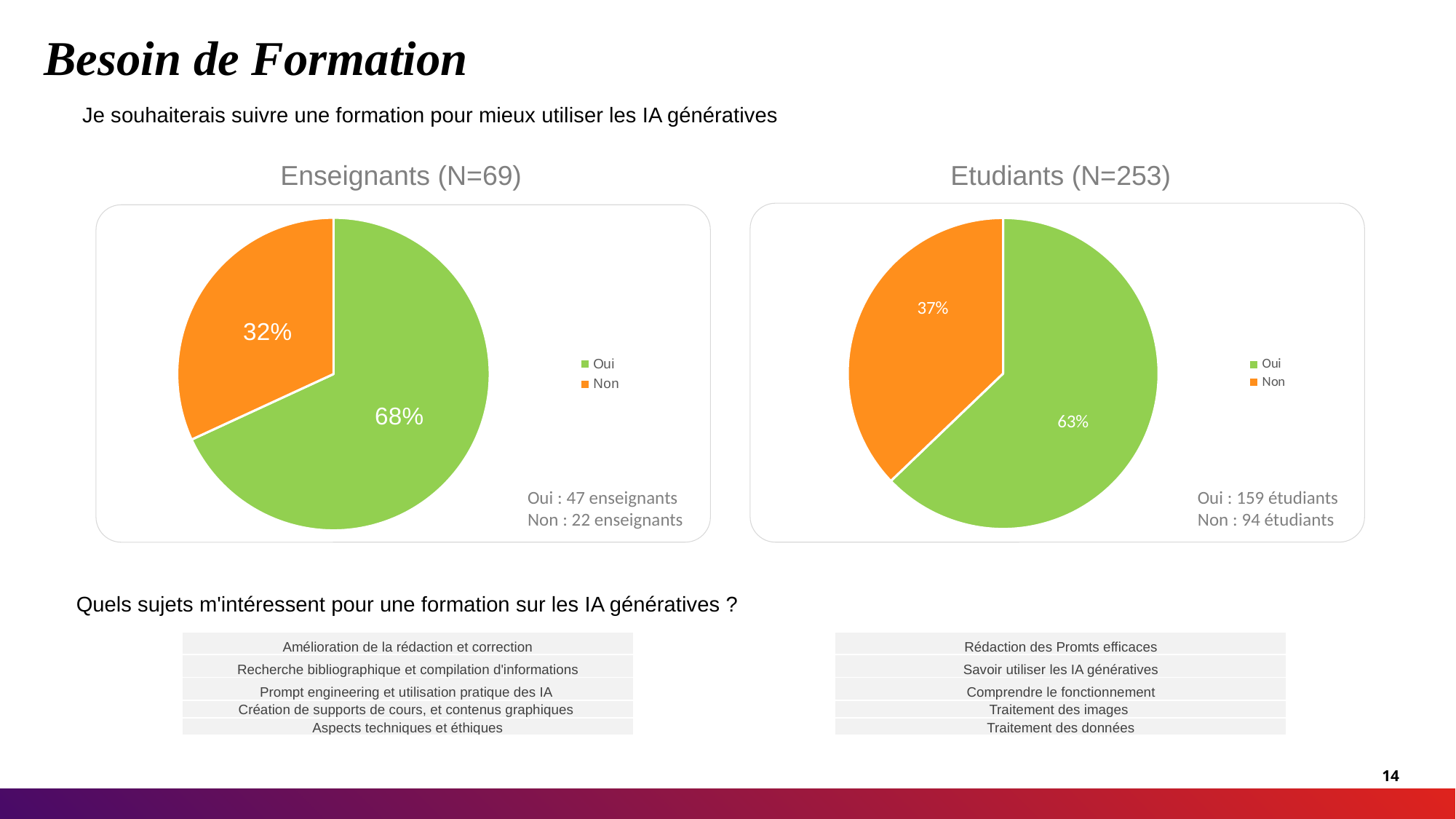
In the Etudiants (N=253) chart, what percentage answered Non? 37% In the Etudiants (N=253) chart, what colour is the Non slice? Orange Which chart has the larger Oui share, Enseignants (N=69) or Etudiants (N=253)? Enseignants (N=69) In the Enseignants (N=69) chart, which response has the largest slice? Oui In the Etudiants (N=253) chart, what is the difference in percentage points between Oui and Non? 26 In the Enseignants (N=69) chart, what percentage answered Oui? 68% In the Etudiants (N=253) chart, what percentage answered Oui? 63% In the Etudiants (N=253) chart, which response has the smallest slice? Non In the Enseignants (N=69) chart, what is the difference in percentage points between Oui and Non? 36 What type of chart is the Enseignants (N=69) chart? Pie chart In the Enseignants (N=69) chart, what percentage answered Non? 32% How many categories does the legend of the Etudiants (N=253) chart list? 2